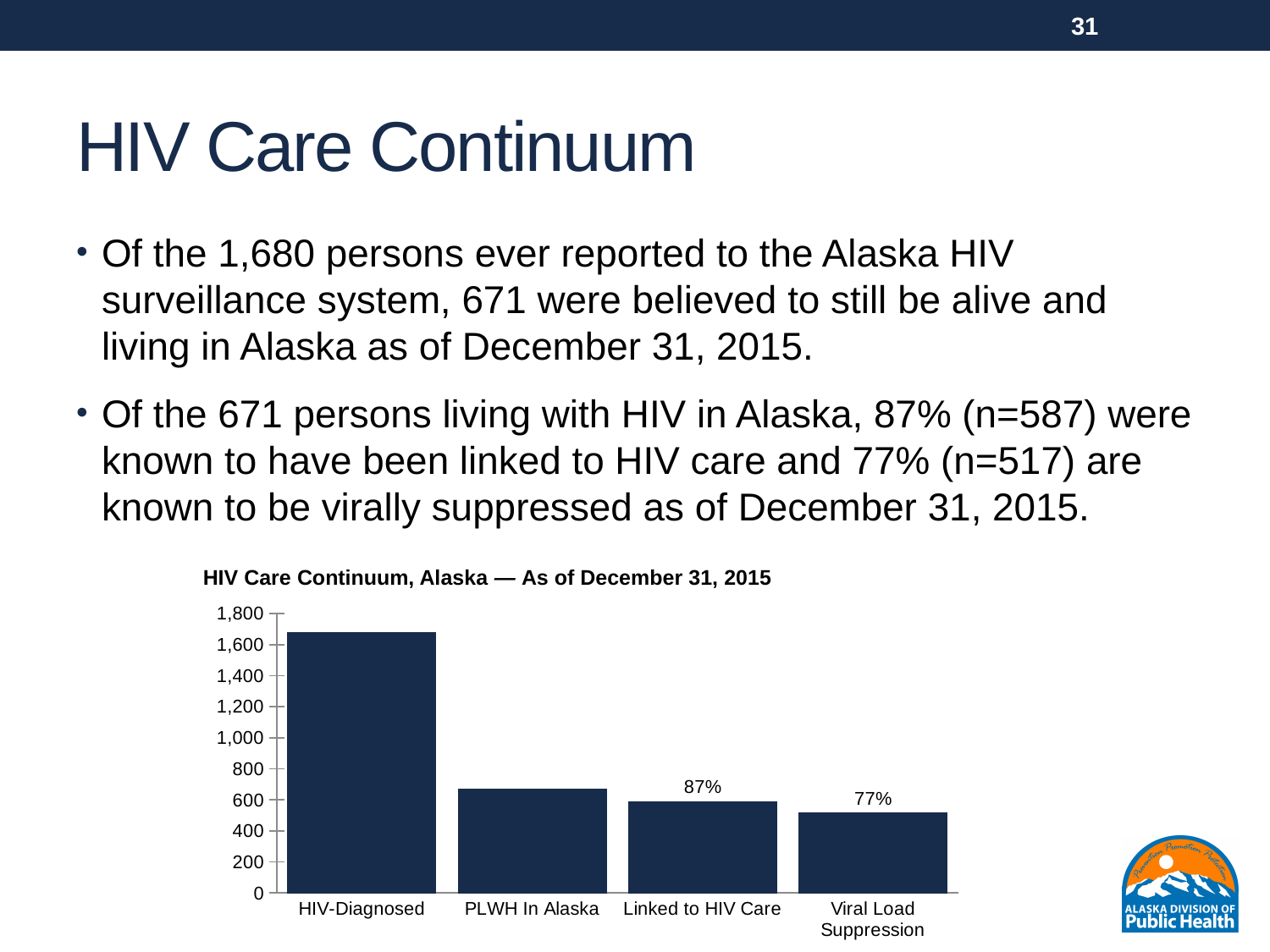
Which category has the lowest bar in the chart? Viral Load Suppression Is the value for HIV-Diagnosed greater or less than 1,600? greater Is the value for Viral Load Suppression greater or less than 400? greater How many categories are shown on the x axis of the chart? 4 Which bar is taller, PLWH In Alaska or Linked to HIV Care? PLWH In Alaska Is the value for PLWH In Alaska greater or less than 800? less What kind of chart is shown on the slide? bar chart Do the bar values rise or fall moving from left to right across the x axis? fall What is the title of the chart? HIV Care Continuum, Alaska — As of December 31, 2015 What percentage label is shown above the Linked to HIV Care bar? 87% Which category has the highest bar in the chart? HIV-Diagnosed What percentage label is shown above the Viral Load Suppression bar? 77%